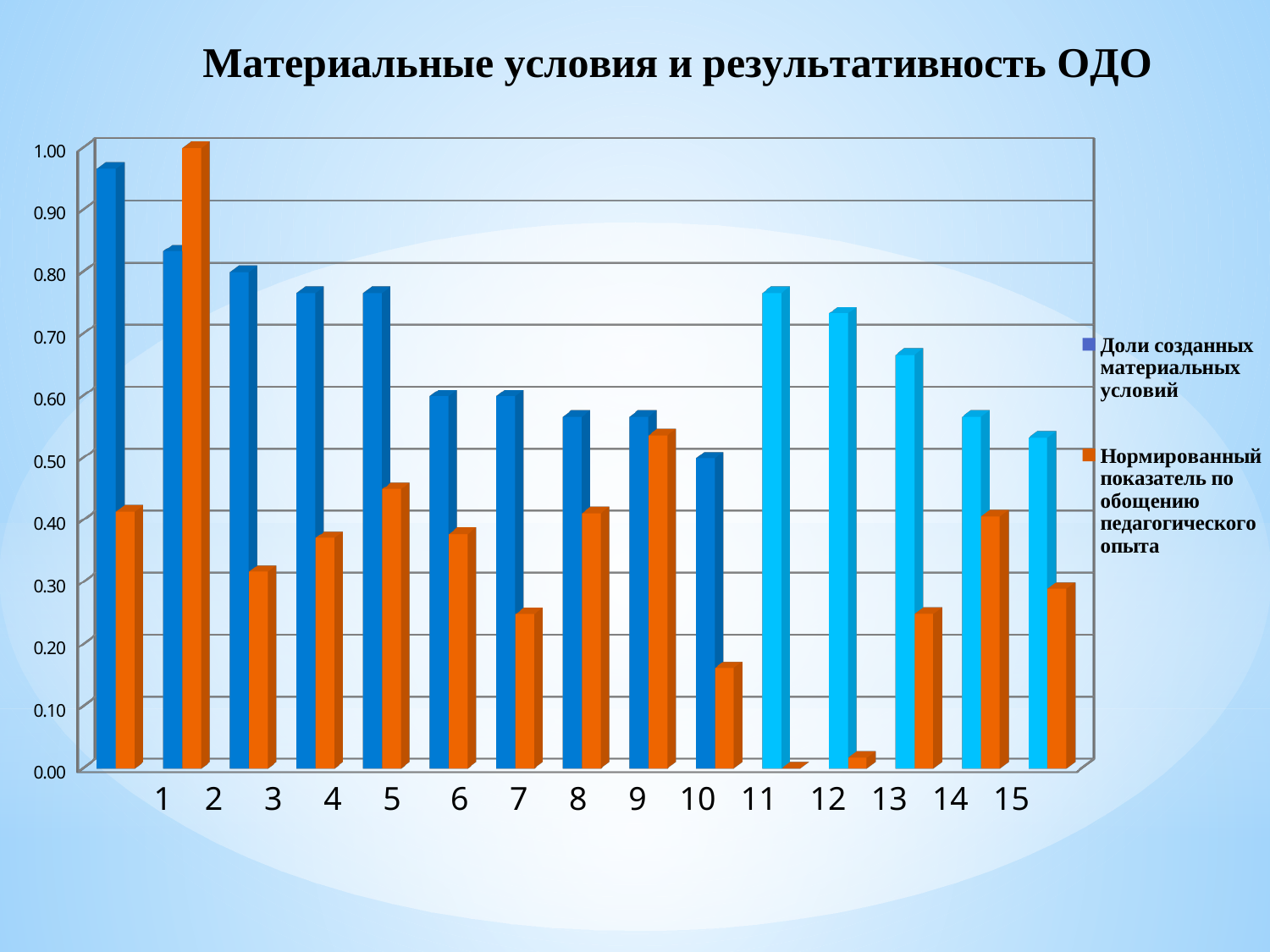
Is the value of 'Доли созданных материальных условий' for category 1 greater or less than 0.90? greater For category 1, which series has the larger value: 'Доли созданных материальных условий' or 'Нормированный показатель по обощению педагогического опыта'? Доли созданных материальных условий For which category is the value of 'Нормированный показатель по обощению педагогического опыта' the lowest? 11 Is the value of 'Нормированный показатель по обощению педагогического опыта' for category 10 greater or less than 0.20? less What is the title of the chart? Материальные условия и результативность ОДО How many series does the legend list? 2 For which category is the value of 'Нормированный показатель по обощению педагогического опыта' the highest? 2 For category 2, which series has the larger value: 'Доли созданных материальных условий' or 'Нормированный показатель по обощению педагогического опыта'? Нормированный показатель по обощению педагогического опыта Which series is shown in orange according to the legend? Нормированный показатель по обощению педагогического опыта What kind of chart is shown on the slide? bar chart For which category is the value of 'Доли созданных материальных условий' the highest? 1 How many categories are shown along the x axis? 15